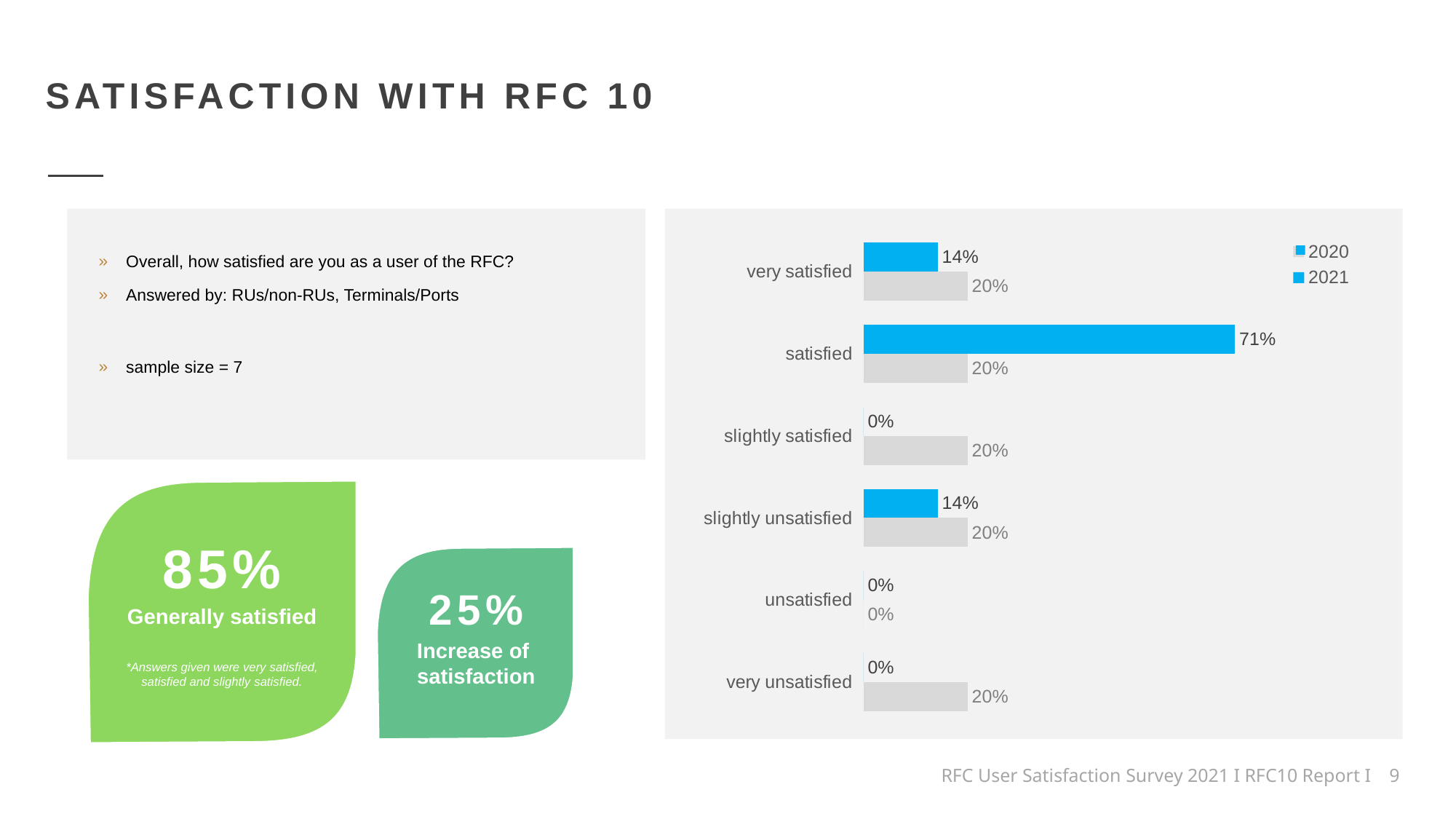
Which category has the highest 2021 value? satisfied Which is larger for "very satisfied": the 2020 value or the 2021 value? 2020 What is the 2021 value for "satisfied"? 71% What is the 2021 value for "slightly unsatisfied"? 14% What is the 2020 value for "unsatisfied"? 0% Which series is shown in blue in the legend? 2021 How many categories are shown on the chart? 6 What is the 2020 value for "very satisfied"? 20% What is the 2021 value for "very unsatisfied"? 0% What kind of chart is shown on the slide? bar chart How many series does the legend list? 2 What is the difference between the 2021 and 2020 values for "satisfied"? 51%